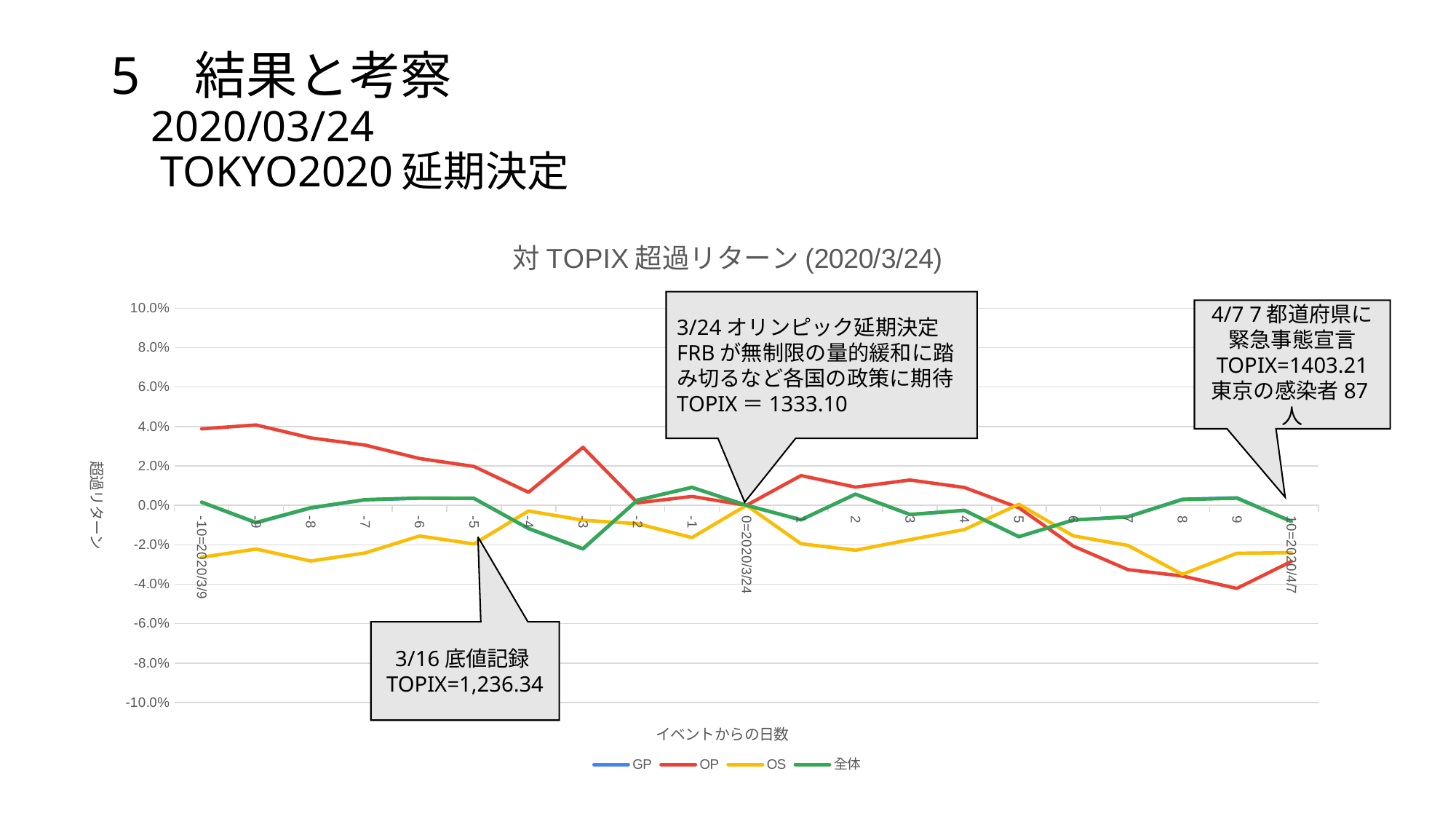
Is the value for 全体 at day -3 greater or less than 0.0%? less At day 9, which is larger, the value for OS or the value for OP? OS Does the OP line rise or fall from day -10 to day -4? fall At day -10, which is larger, the value for OP or the value for OS? OP What kind of chart is shown on the slide? line chart Is the value for OS at day -8 greater or less than -2.0%? less Is the value for OP at day 9 greater or less than -2.0%? less Which series has the highest value at day -9? OP Which series has the lowest value at day -10? OS How many series does the legend list? 4 How many points are there along the x axis (from -10 to 10)? 21